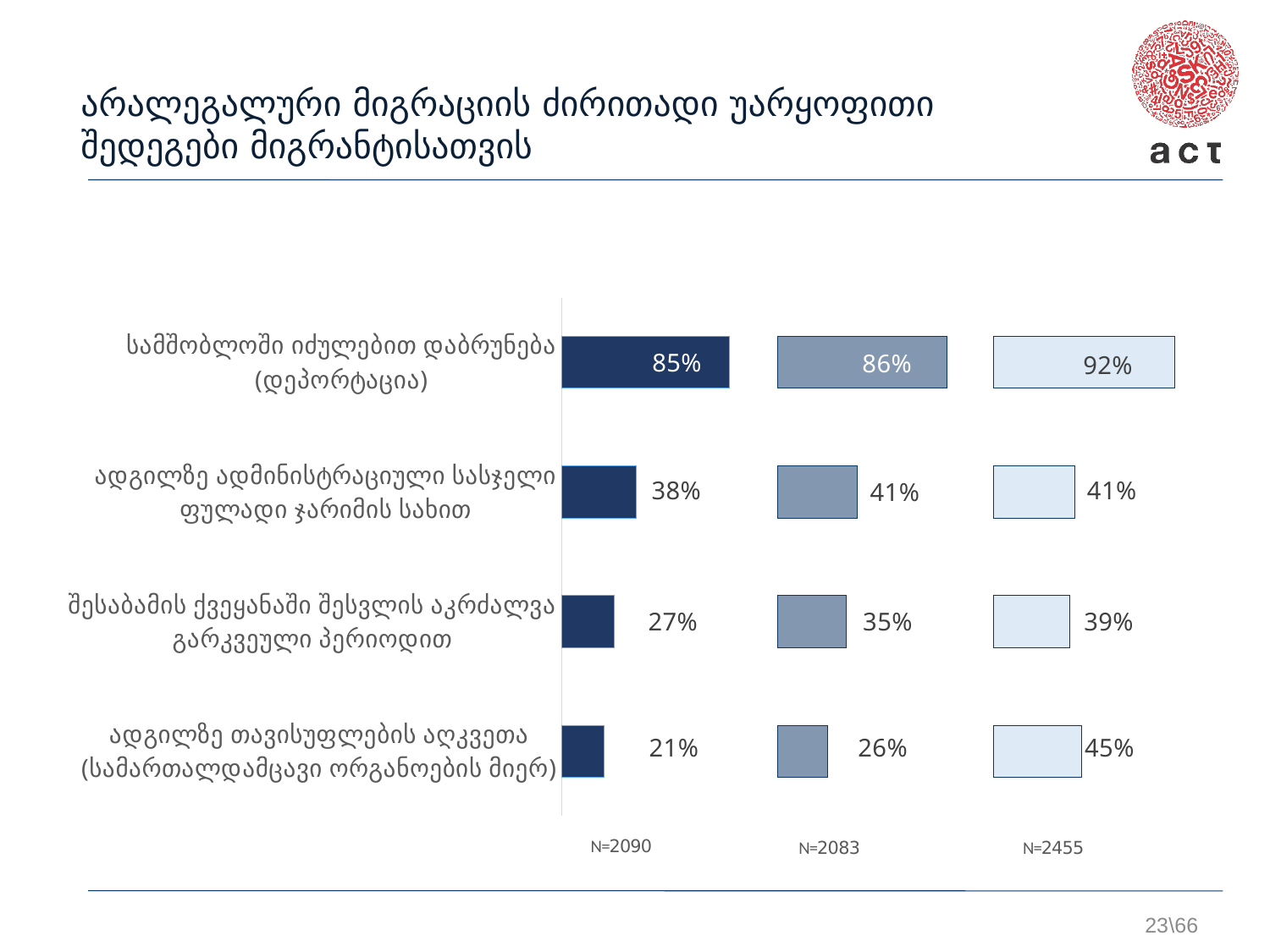
What is the value for 'ადგილზე თავისუფლების აღკვეთა (სამართალდამცავი ორგანოების მიერ)' in the N=2083 series? 26% What sample size is shown under the darkest (leftmost) series of bars? N=2090 What is the value for 'სამშობლოში იძულებით დაბრუნება (დეპორტაცია)' in the N=2090 series? 85% Which category has the highest value in the N=2455 series? სამშობლოში იძულებით დაბრუნება (დეპორტაცია) What is the value for 'შესაბამის ქვეყანაში შესვლის აკრძალვა გარკვეული პერიოდით' in the N=2090 series? 27% How many categories are plotted on the chart? 4 What is the value for 'სამშობლოში იძულებით დაბრუნება (დეპორტაცია)' in the N=2455 series? 92% What is the difference between the N=2455 and N=2090 values for 'ადგილზე თავისუფლების აღკვეთა (სამართალდამცავი ორგანოების მიერ)'? 24% What type of chart is shown on the slide? bar chart What is the difference between the N=2083 and N=2090 values for 'ადგილზე ადმინისტრაციული სასჯელი ფულადი ჯარიმის სახით'? 3% Which category has the lowest value in the N=2090 series? ადგილზე თავისუფლების აღკვეთა (სამართალდამცავი ორგანოების მიერ) For 'შესაბამის ქვეყანაში შესვლის აკრძალვა გარკვეული პერიოდით', which series has the larger value, N=2083 or N=2455? N=2455